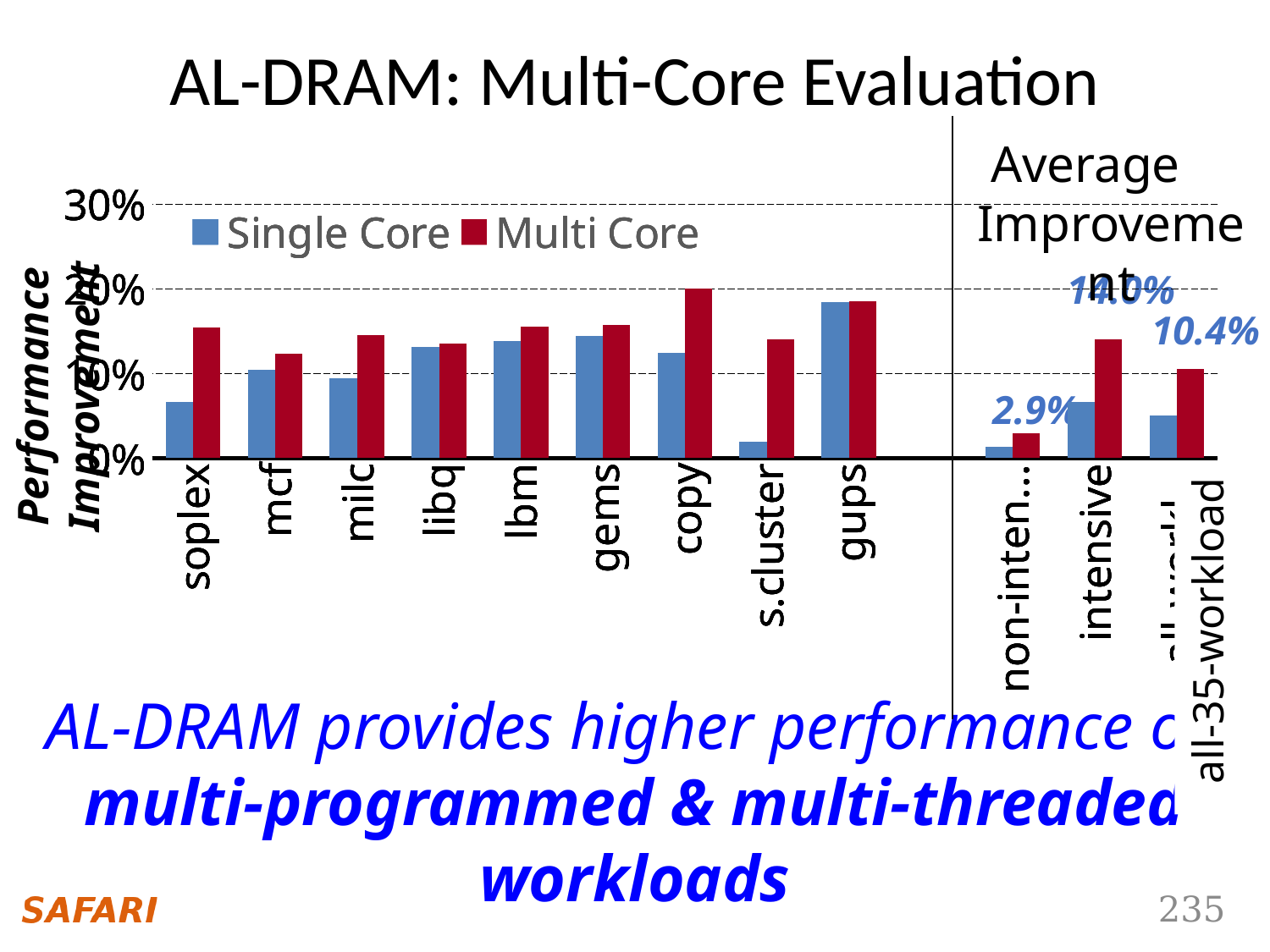
What value is labelled for the Multi Core bar of all-35-workload? 10.4% How many series does the chart's legend list? 2 For soplex, which is larger: the Single Core value or the Multi Core value? Multi Core What kind of chart is shown on the slide? bar chart Is the Multi Core value for copy greater or less than 10%? greater Is the Multi Core value for intensive greater or less than 10%? greater Is the Single Core value for s.cluster greater or less than 10%? less Which category has the highest Single Core value? gups What is the title of the chart on the slide? AL-DRAM: Multi-Core Evaluation What are the two series named in the chart's legend? Single Core and Multi Core Which category has the highest Multi Core value? copy